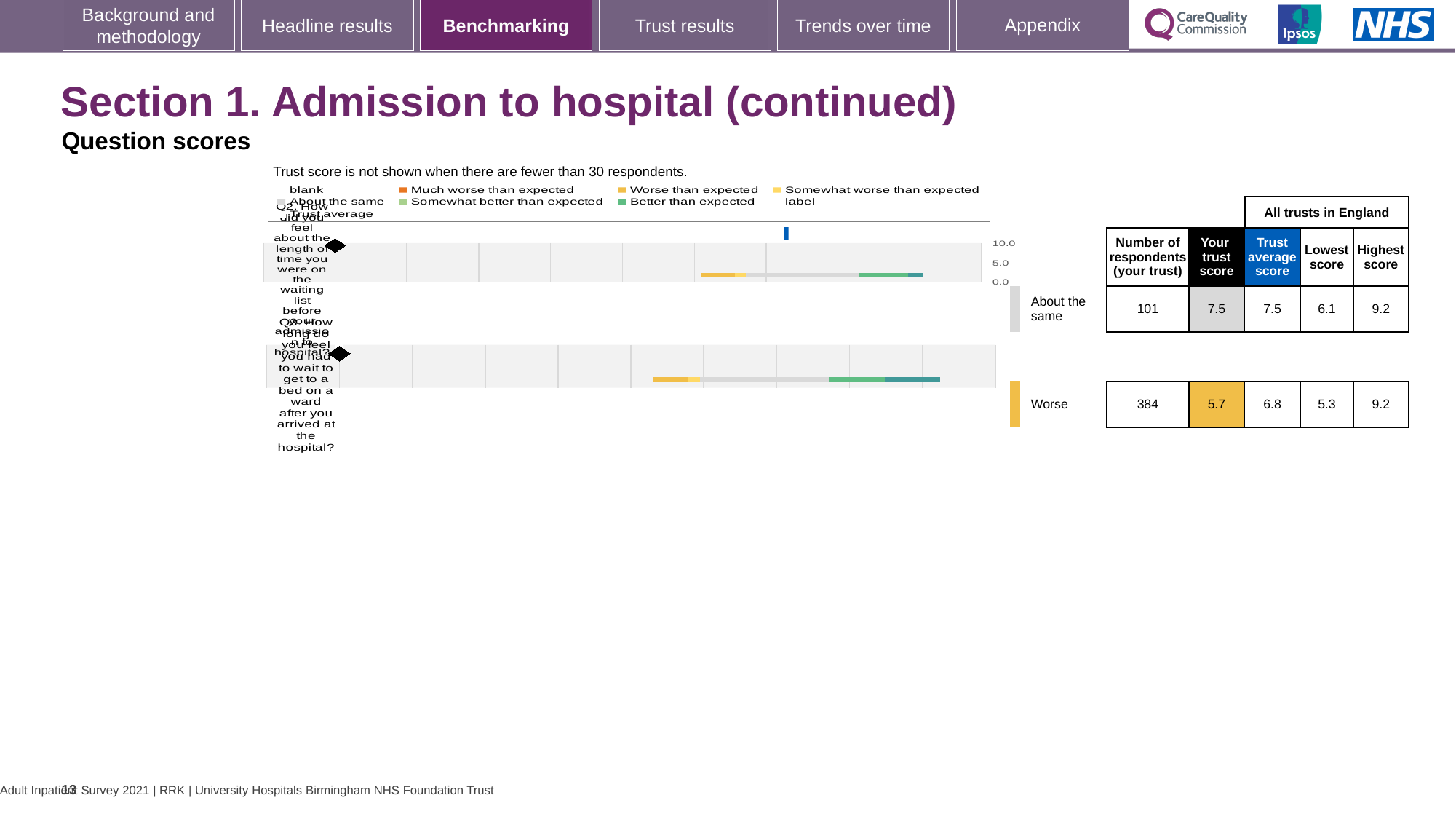
What is the lowest score across all trusts in England for Q2? 6.1 Is the trust score for Q3 greater or less than 5.0? greater Which question has the higher trust score, Q2 or Q3? Q2 How many respondents answered Q3 at this trust? 384 How many questions are plotted on the chart? 2 What kind of chart is used to show the question scores? Bar chart What is the highest score across all trusts in England for Q3? 9.2 What benchmark category is shown for Q3? Worse What is the trust score for Q2 (length of time on the waiting list before admission)? 7.5 What is the trust score for Q3 (how long you had to wait to get to a bed on a ward)? 5.7 What is the difference between the trust average score and this trust's score for Q3? 1.1 What is the trust average score for Q3? 6.8